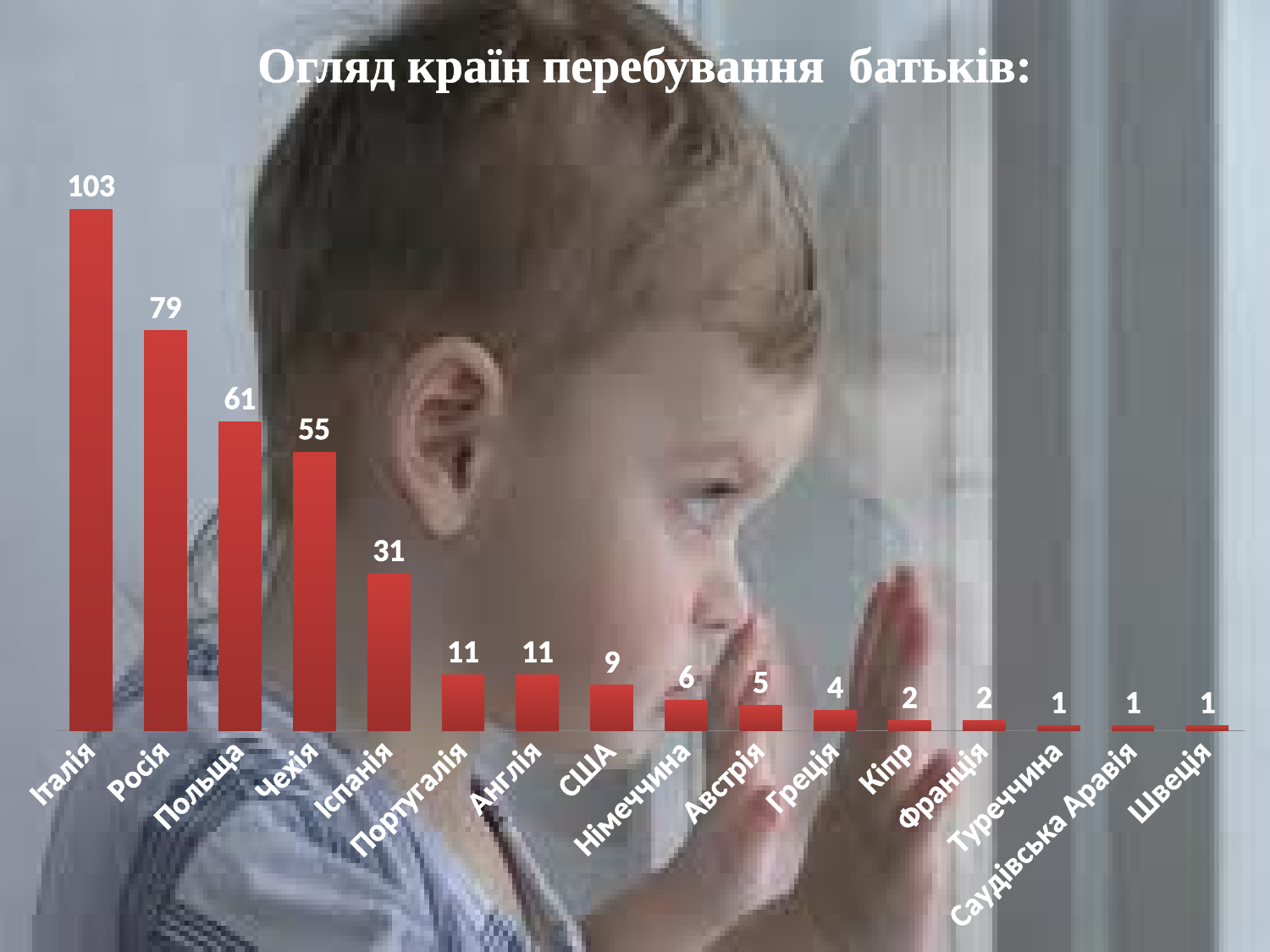
What is the difference between the values for Італія and Росія? 24 Which is larger, the value for США or the value for Австрія? США How many countries are shown in the chart? 16 Which country has the highest value? Італія What is the value for Італія? 103 What is the difference between the values for Польща and Чехія? 6 What kind of chart is shown on the slide? bar chart What is the title of the chart? Огляд країн перебування батьків: What is the value for Німеччина? 6 What is the value for Іспанія? 31 What is the value for Чехія? 55 Which is larger, the value for Росія or the value for Польща? Росія